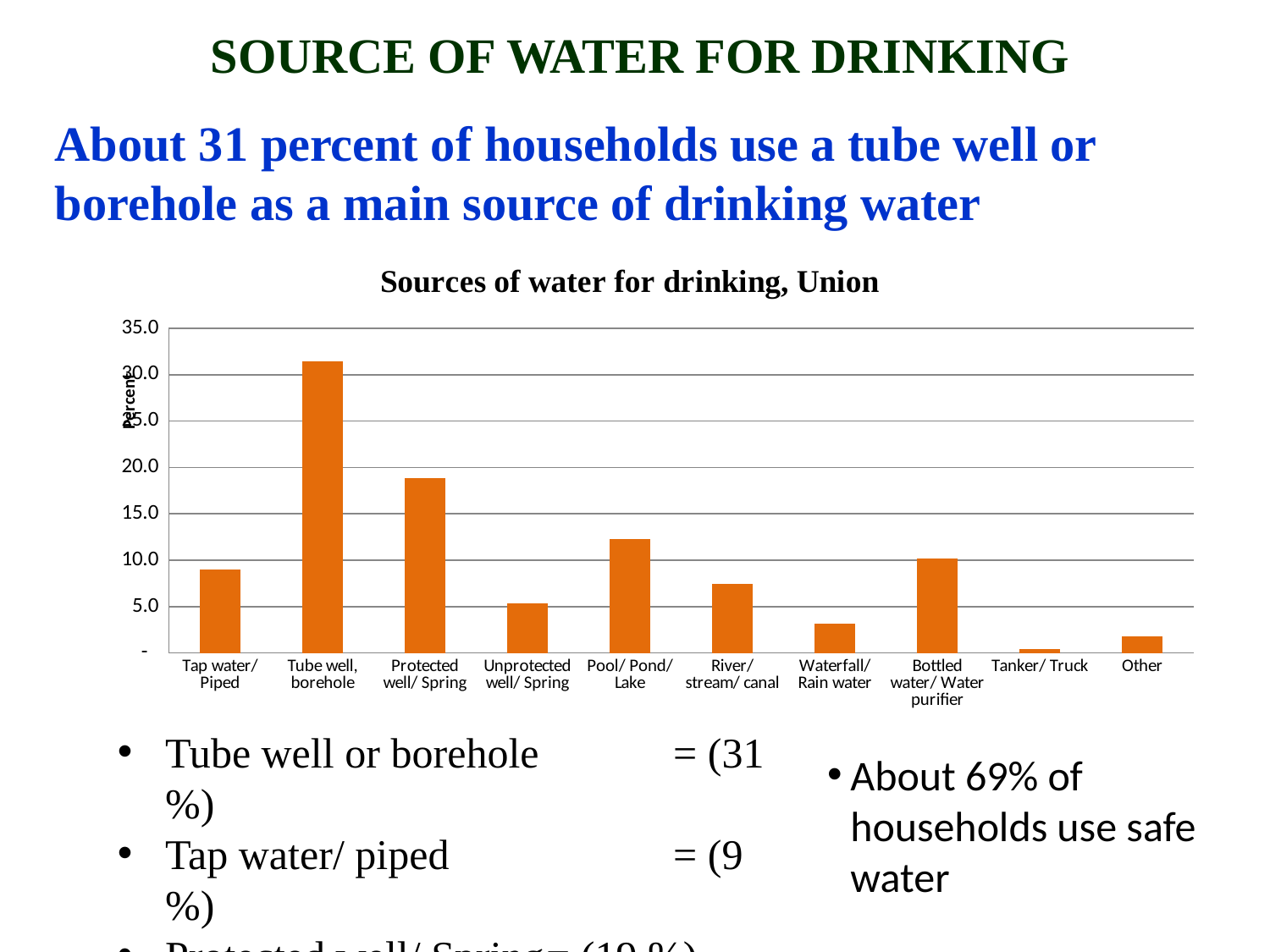
Is the value for Tube well, borehole greater or less than 30.0? greater Which water source has the highest bar in the chart? Tube well, borehole Which water source has the lowest bar in the chart? Tanker/ Truck How many water source categories are shown on the x axis of the chart? 10 Is the value for Protected well/ Spring greater or less than 20.0? less What is the title of the chart? Sources of water for drinking, Union Is the value for Waterfall/ Rain water greater or less than 5.0? less Which is larger, the value for Protected well/ Spring or the value for Pool/ Pond/ Lake? Protected well/ Spring Which is larger, the value for River/ stream/ canal or the value for Bottled water/ Water purifier? Bottled water/ Water purifier What kind of chart is shown on the slide? bar chart